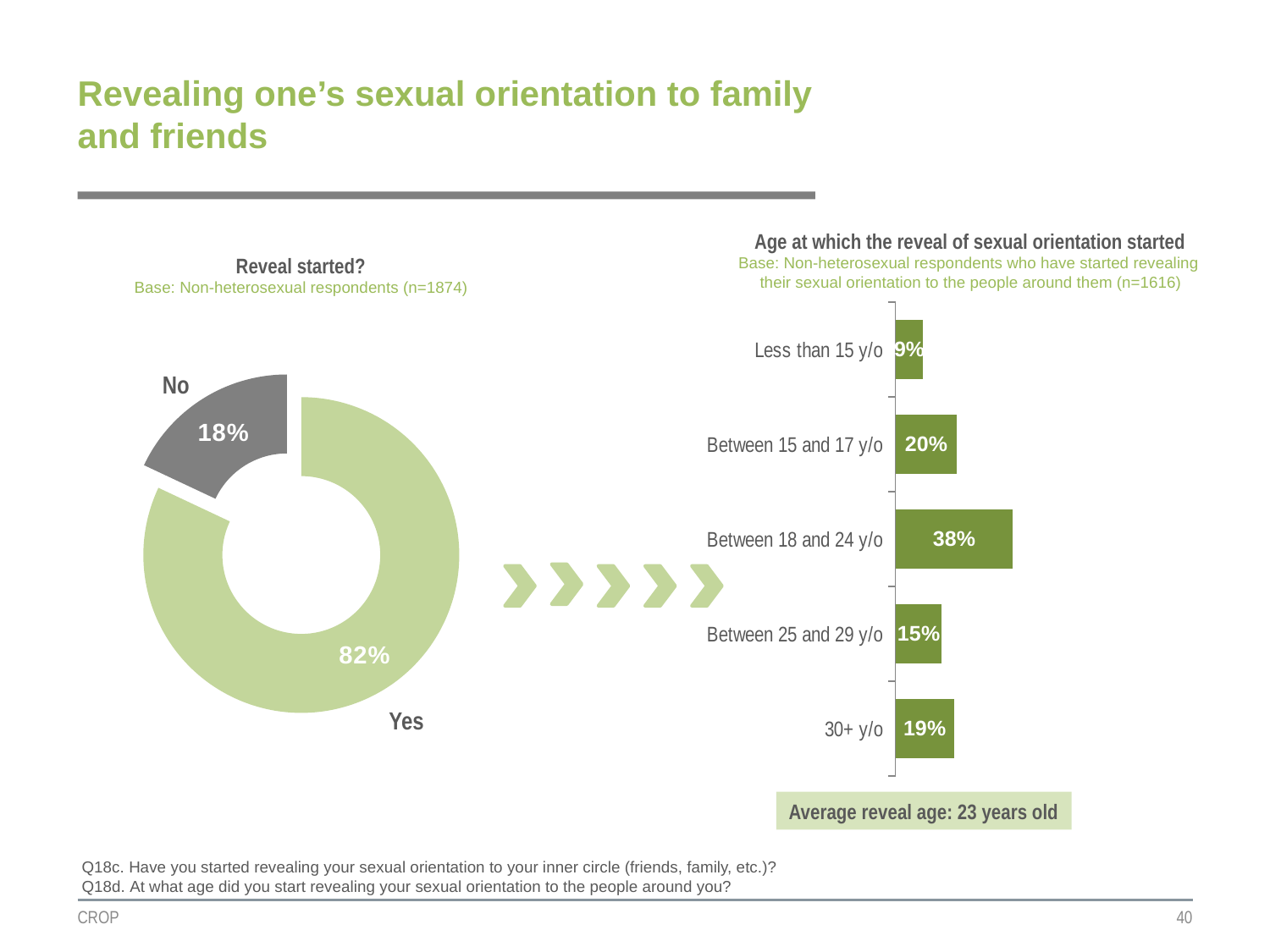
In the 'Age at which the reveal of sexual orientation started' chart, which age group has the highest value? Between 18 and 24 y/o In the 'Age at which the reveal of sexual orientation started' chart, what is the value for 30+ y/o? 19% In the 'Age at which the reveal of sexual orientation started' chart, which age group has the lowest value? Less than 15 y/o In the 'Reveal started?' chart, what percentage of respondents answered Yes? 82% In the 'Age at which the reveal of sexual orientation started' chart, which is larger: Between 25 and 29 y/o or 30+ y/o? 30+ y/o What kind of chart is the 'Reveal started?' chart? Doughnut chart In the 'Age at which the reveal of sexual orientation started' chart, what is the value for Less than 15 y/o? 9% In the 'Age at which the reveal of sexual orientation started' chart, what is the value for Between 18 and 24 y/o? 38% What kind of chart is the 'Age at which the reveal of sexual orientation started' chart? Bar chart In the 'Age at which the reveal of sexual orientation started' chart, what is the difference between Between 18 and 24 y/o and Between 15 and 17 y/o? 18% In the 'Reveal started?' chart, what percentage of respondents answered No? 18% In the 'Reveal started?' chart, how many categories are shown? 2